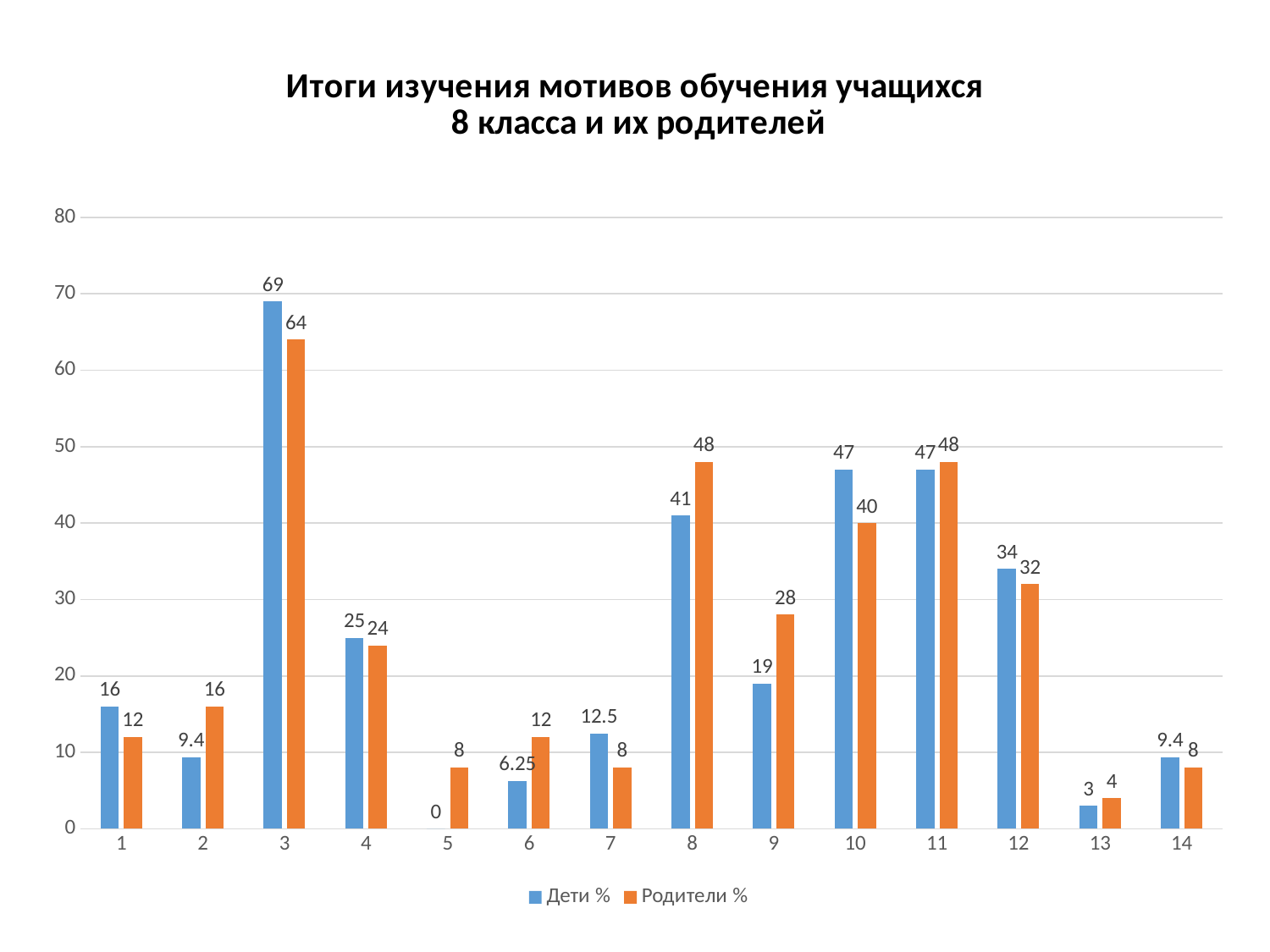
How many series does the legend list? 2 Which category has the highest Родители % value? 3 What kind of chart is shown on the slide? Bar chart Which category has the lowest Дети % value? 5 What is the value of Дети % for category 3? 69 For category 10, which is larger: Дети % or Родители %? Дети % How many categories are shown on the x axis? 14 Is the Дети % value for category 12 greater or less than 30? greater What is the difference between Дети % and Родители % for category 8? 7 What is the value of Дети % for category 7? 12.5 What colour are the Родители % bars? Orange What is the value of Родители % for category 9? 28